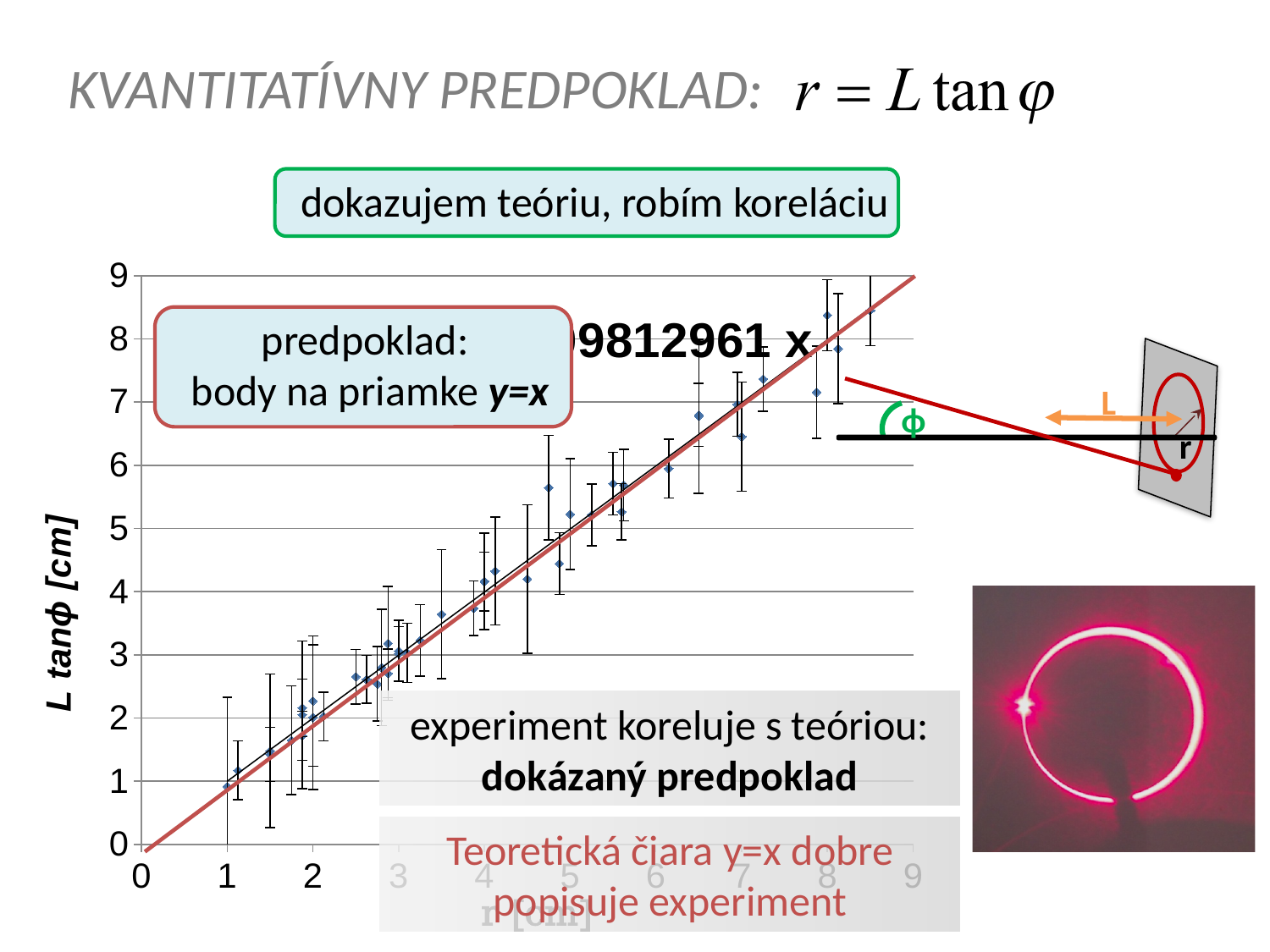
What is the highest tick value shown on the vertical axis? 9 Is the plotted value at r = 1 greater or less than 2? less Do the plotted values rise or fall as r increases along the x axis? rise Is the plotted value at r = 2 greater or less than 3? less What is the label of the vertical axis? L tanφ [cm] Is the plotted value at r = 7 greater or less than 6? greater What kind of chart is shown on the slide? scatter chart